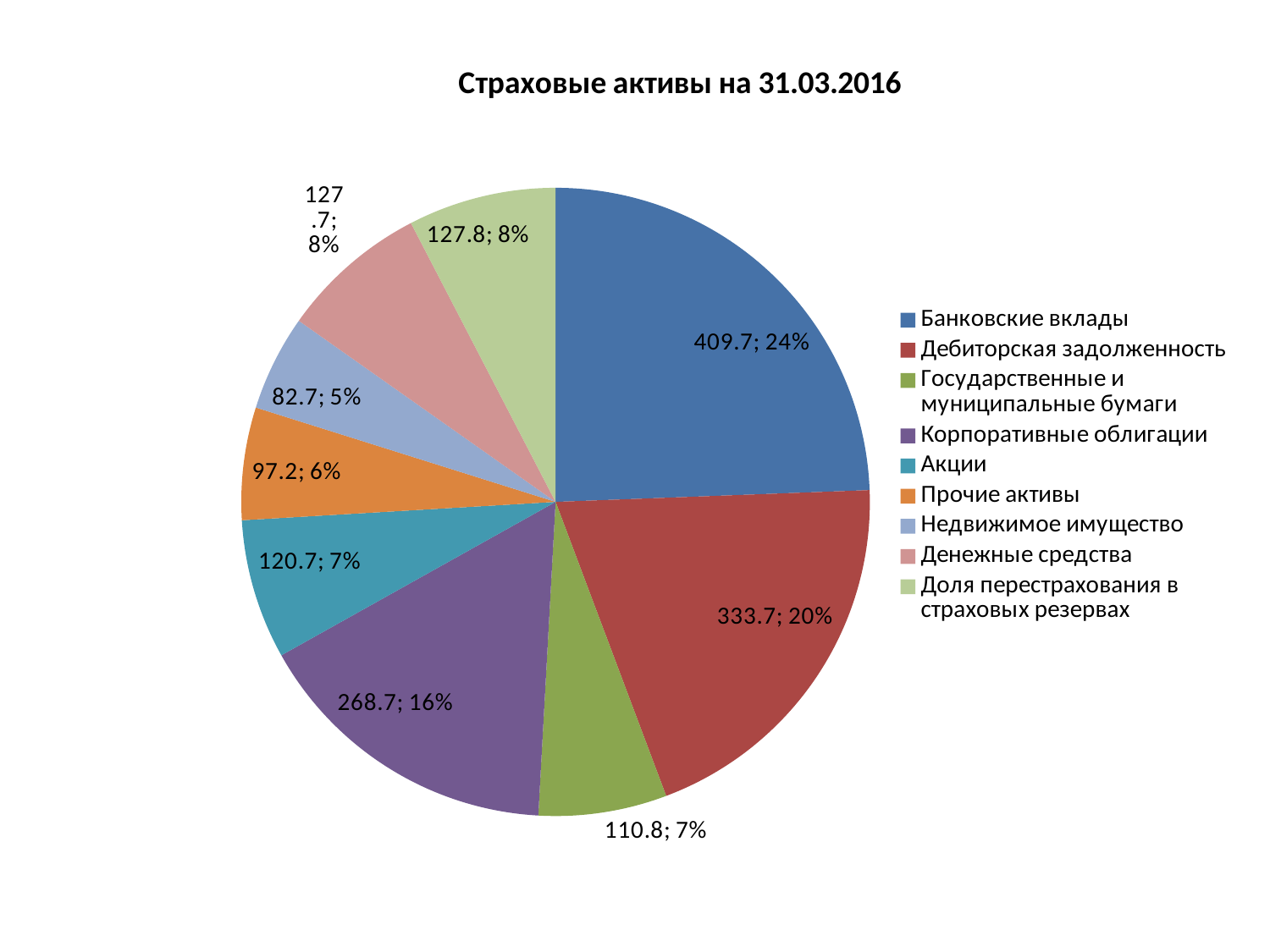
What is the title of the chart? Страховые активы на 31.03.2016 What is the value shown for Корпоративные облигации? 268.7 How many categories does the legend list? 9 What share of the pie does Недвижимое имущество represent? 5% Which category has the smallest slice of the pie? Недвижимое имущество What is the value shown for Государственные и муниципальные бумаги? 110.8 What is the difference between the values for Банковские вклады and Дебиторская задолженность? 76 Which is larger, the value for Акции or the value for Прочие активы? Акции Which category has the largest slice of the pie? Банковские вклады What is the value shown for Банковские вклады? 409.7 What type of chart is shown on the slide? pie chart What share of the pie does Дебиторская задолженность represent? 20%